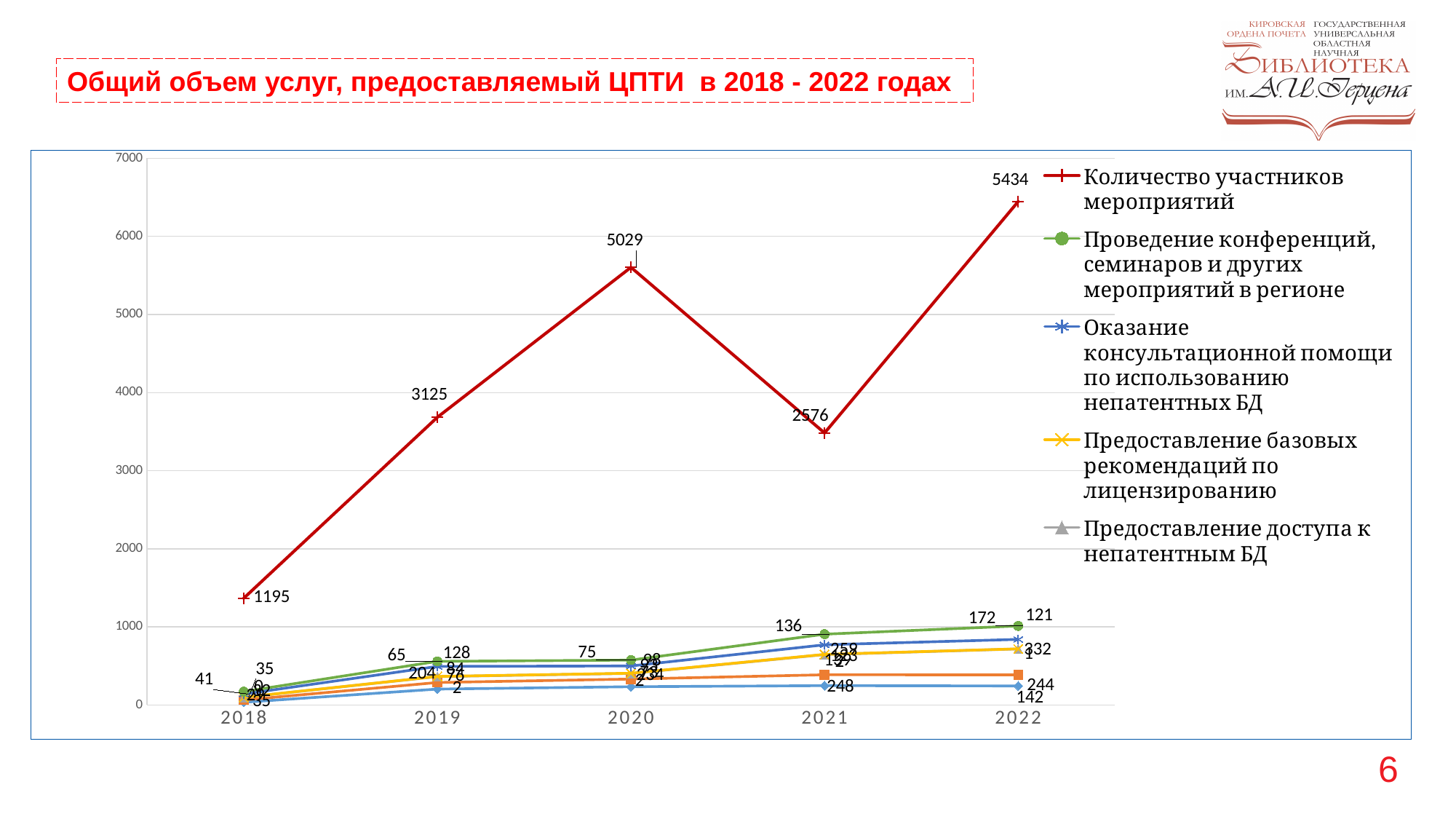
How many years are shown on the x axis of the chart? 5 What is the value of 'Количество участников мероприятий' in 2021? 2576 How many series does the chart legend list? 5 What is the value of 'Проведение конференций, семинаров и других мероприятий в регионе' in 2022? 172 What is the value of 'Количество участников мероприятий' in 2020? 5029 In which year is 'Количество участников мероприятий' lowest? 2018 What is the value of 'Количество участников мероприятий' in 2018? 1195 In which year is 'Количество участников мероприятий' highest? 2022 Does 'Количество участников мероприятий' rise or fall from 2020 to 2021? fall Which year has the larger value for 'Количество участников мероприятий': 2019 or 2021? 2019 What is the difference between the 'Количество участников мероприятий' values for 2022 and 2021? 2858 What type of chart is shown on the slide? line chart